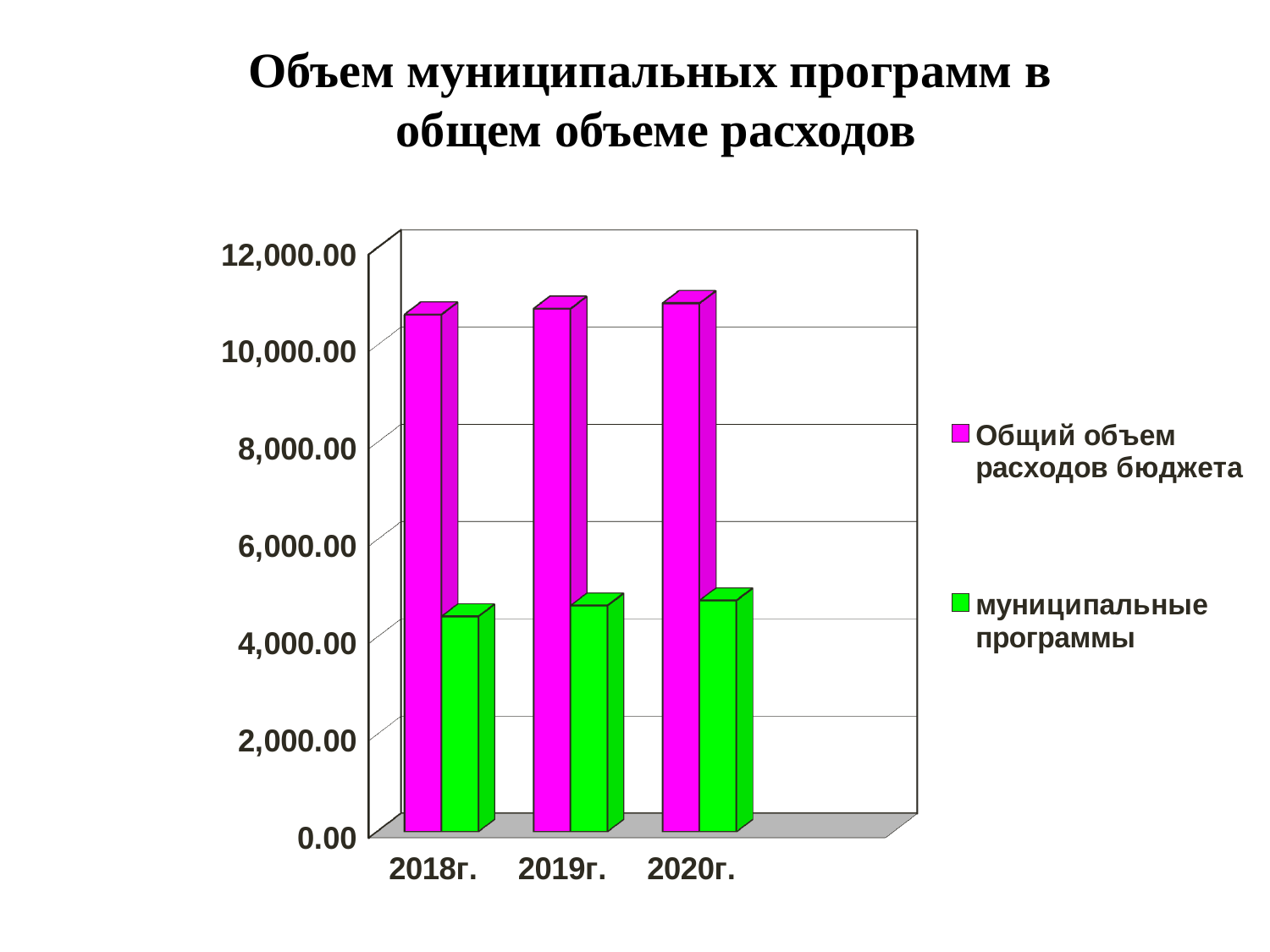
Is the value for "муниципальные программы" in 2018г. greater or less than 6,000.00? less Is the value for "муниципальные программы" in 2020г. greater or less than 4,000.00? greater What is the title of the chart on the slide? Объем муниципальных программ в общем объеме расходов In 2019г., which is larger: "Общий объем расходов бюджета" or "муниципальные программы"? Общий объем расходов бюджета How many series does the chart legend list? 2 How many years are shown on the x axis of the chart? 3 What kind of chart is shown on the slide? bar chart In which year is the value for "муниципальные программы" the lowest? 2018г. Do the values for "муниципальные программы" rise or fall from 2018г. to 2020г.? rise Is the value for "Общий объем расходов бюджета" in 2018г. greater or less than 10,000.00? greater Which colour represents the series "муниципальные программы" in the chart? green